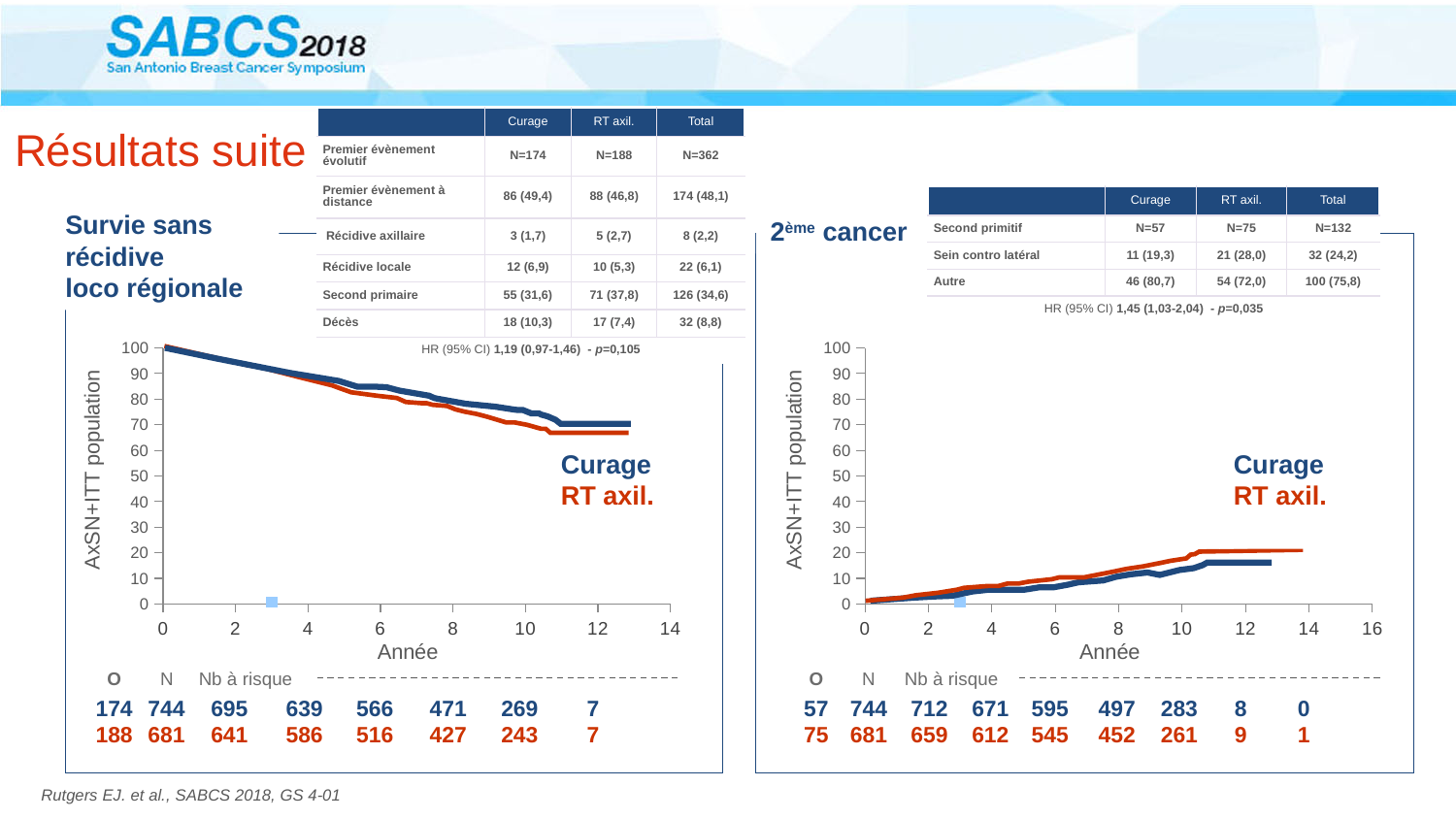
In the '2ème cancer' chart on the right, what are the two series named in the legend? Curage and RT axil. In the '2ème cancer' chart on the right, is the value for RT axil. at year 12 greater or less than 30? less How many series are shown in the 'Survie sans récidive loco régionale' chart on the left? 2 In the 'Survie sans récidive loco régionale' chart on the left, what is the label of the y axis? AxSN+ITT population In the 'Survie sans récidive loco régionale' chart on the left, which series is higher at year 12, Curage or RT axil.? Curage In the 'Survie sans récidive loco régionale' chart on the left, is the value for Curage at year 6 greater or less than 70? greater What kind of chart is the '2ème cancer' chart on the right? line chart In the 'Survie sans récidive loco régionale' chart on the left, do the curves rise or fall as the years increase? fall In the '2ème cancer' chart on the right, which series is higher at year 12, Curage or RT axil.? RT axil. What kind of chart is the 'Survie sans récidive loco régionale' chart on the left? line chart In the '2ème cancer' chart on the right, do the curves rise or fall as the years increase? rise In the '2ème cancer' chart on the right, what is the highest value shown on the x axis? 16